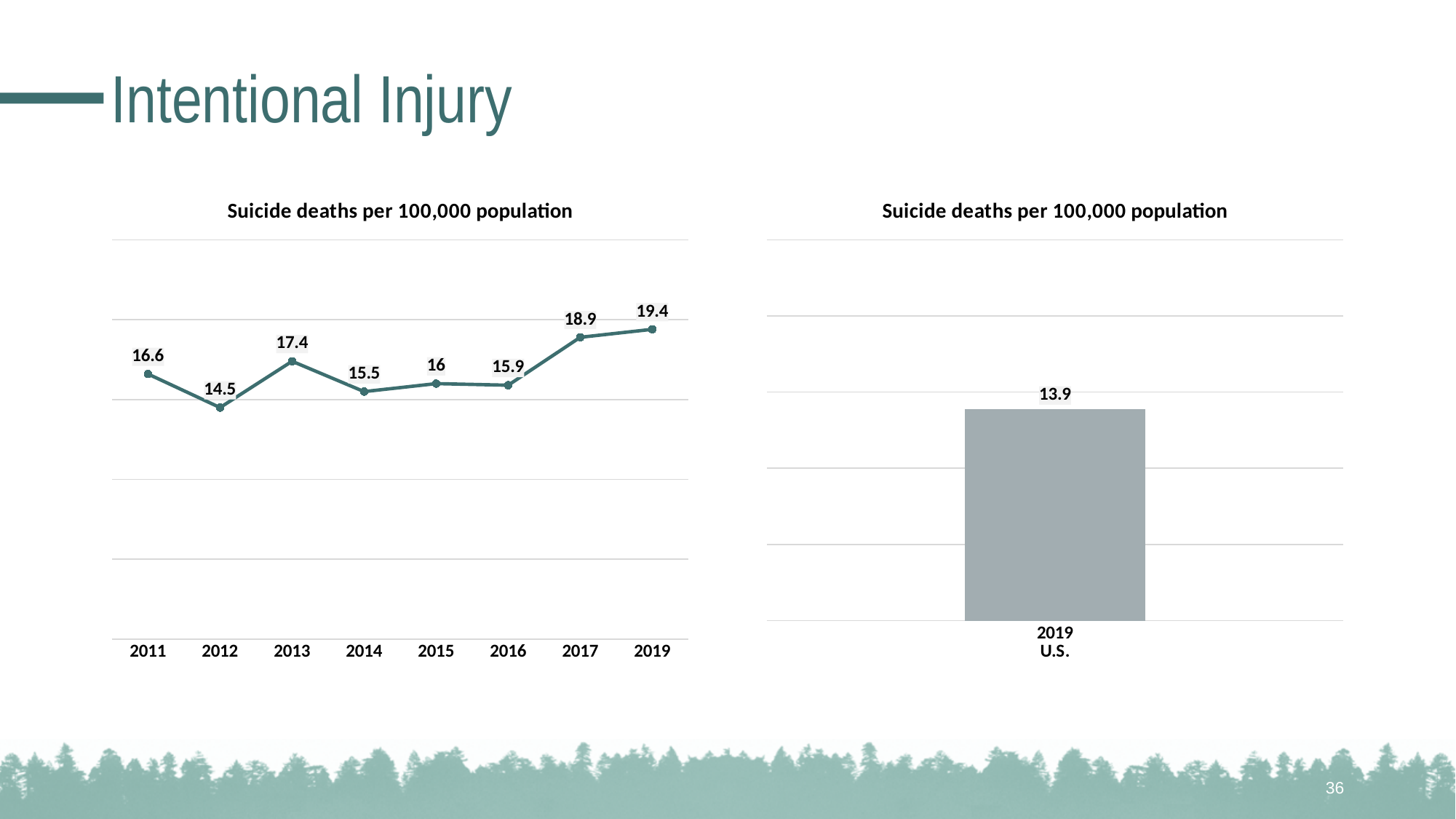
In the left chart, which is larger, the value for 2013 or the value for 2014? 2013 In the left chart, what is the difference between the 2019 value and the 2012 value? 4.9 In the left chart, do the values rise or fall from 2016 to 2019? rise What kind of chart is the right chart? bar chart In the right chart, what is the value for 2019 U.S.? 13.9 What is the title of the right chart? Suicide deaths per 100,000 population In the left chart, which year has the lowest value? 2012 What kind of chart is the left chart? line chart In the left chart, what is the value for 2019? 19.4 In the left chart, what is the value for 2011? 16.6 In the left chart, which year has the highest value? 2019 How many data points are plotted in the left chart? 8